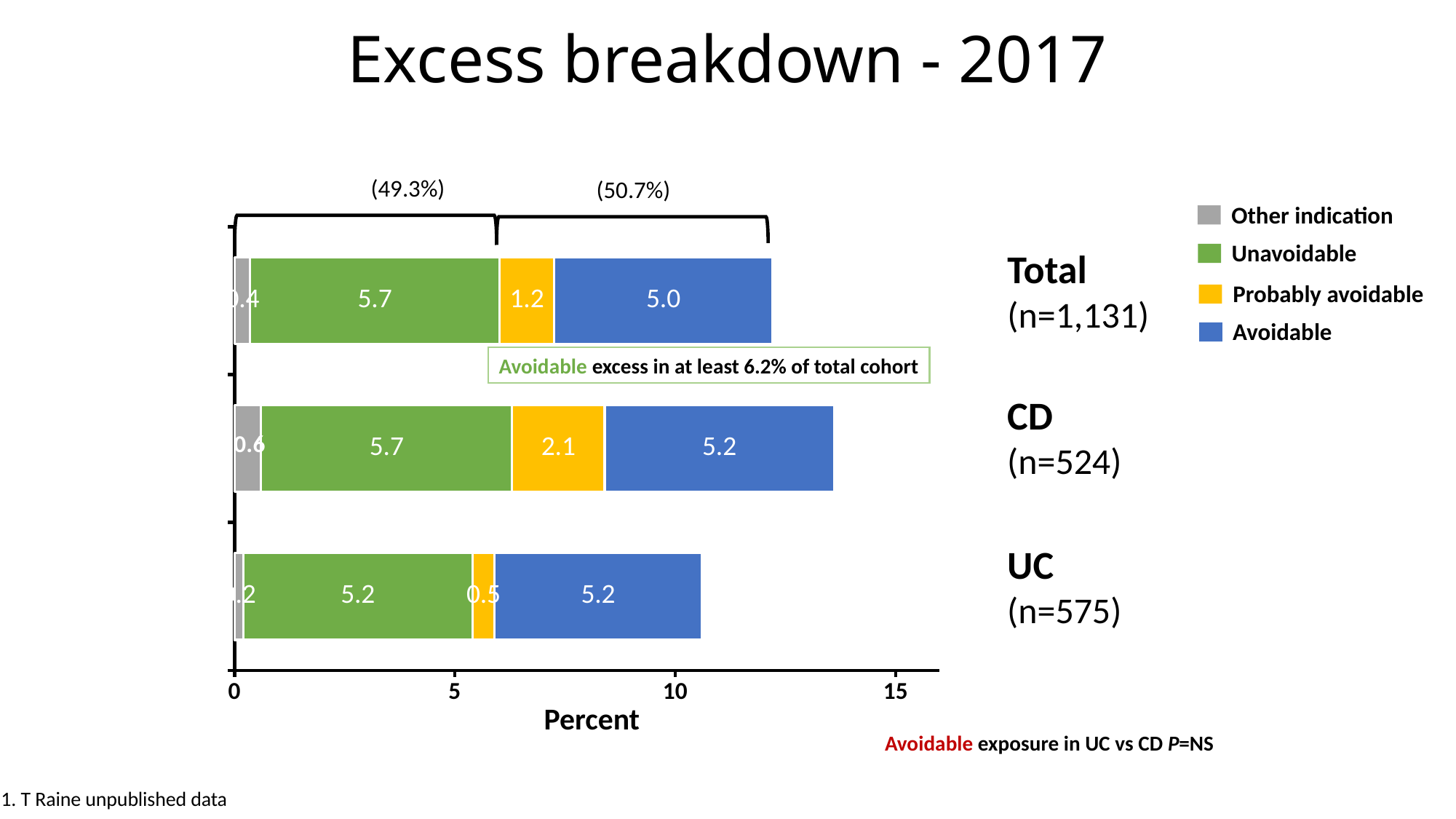
How many series does the legend list? 4 What is the difference between the Probably avoidable values for CD and UC? 1.6 What is the title of the x axis? Percent What is the Probably avoidable value for CD? 2.1 What kind of chart is shown on the slide? bar chart What is the Other indication value for CD? 0.6 Which category has the highest Probably avoidable value? CD Which has the larger Avoidable value, CD or Total? CD What is the Unavoidable value for UC? 5.2 How many categories (bars) are plotted in the chart? 3 What is the Avoidable value for Total? 5.0 What is the total of the stacked bar for CD? 13.6